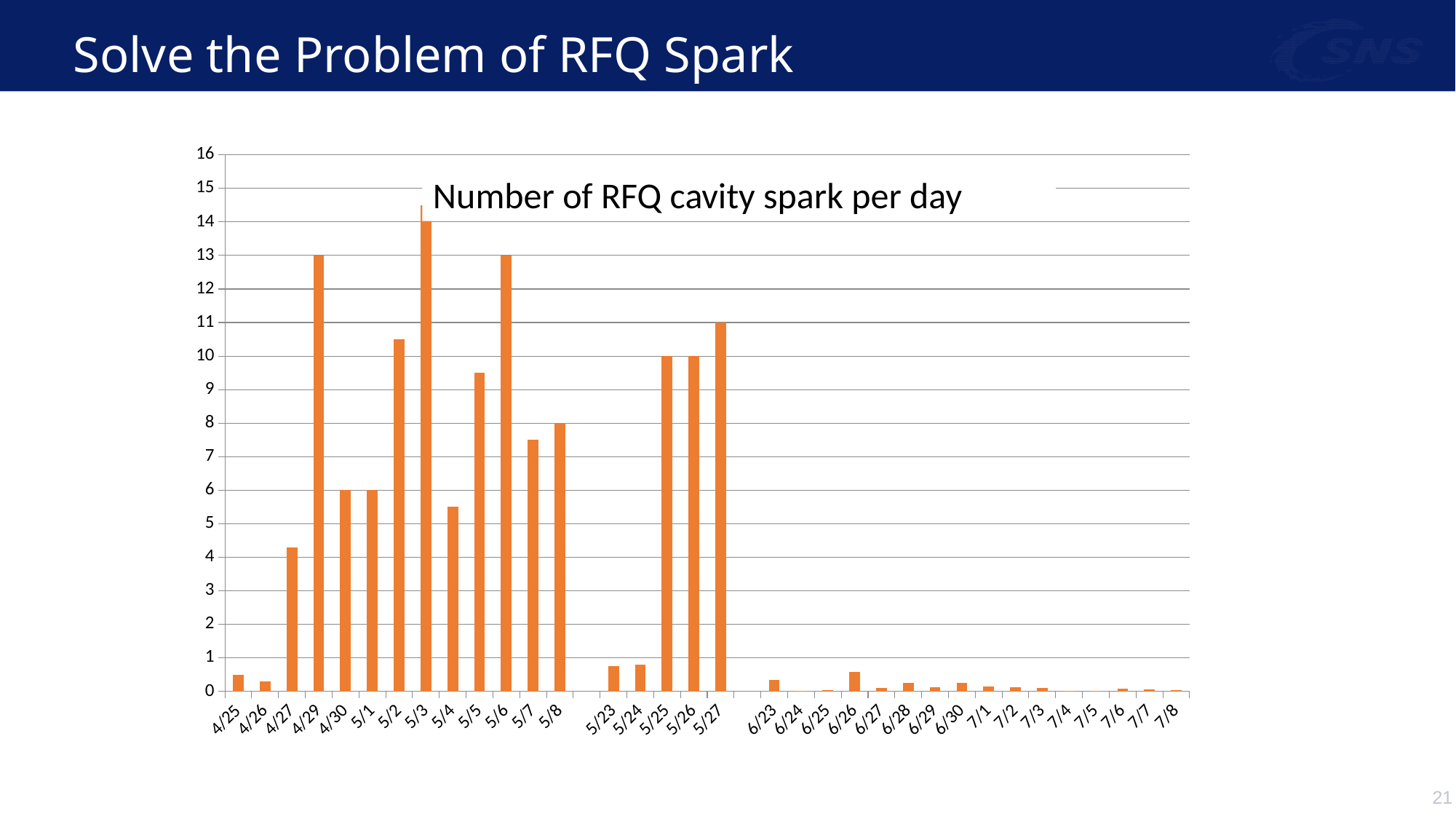
Which is larger, the value for 5/27 or the value for 5/8? 5/27 Is the value for 5/5 greater or less than 10? less Is the value for 5/2 greater or less than 10? greater What kind of chart is shown on the slide? bar chart What is the number of RFQ cavity sparks on 5/8? 8 What is the number of RFQ cavity sparks on 4/29? 13 Which date has the highest number of RFQ cavity sparks? 5/3 What is the title of the chart? Number of RFQ cavity spark per day Is the value for 4/27 greater or less than 5? less What is the number of RFQ cavity sparks on 5/27? 11